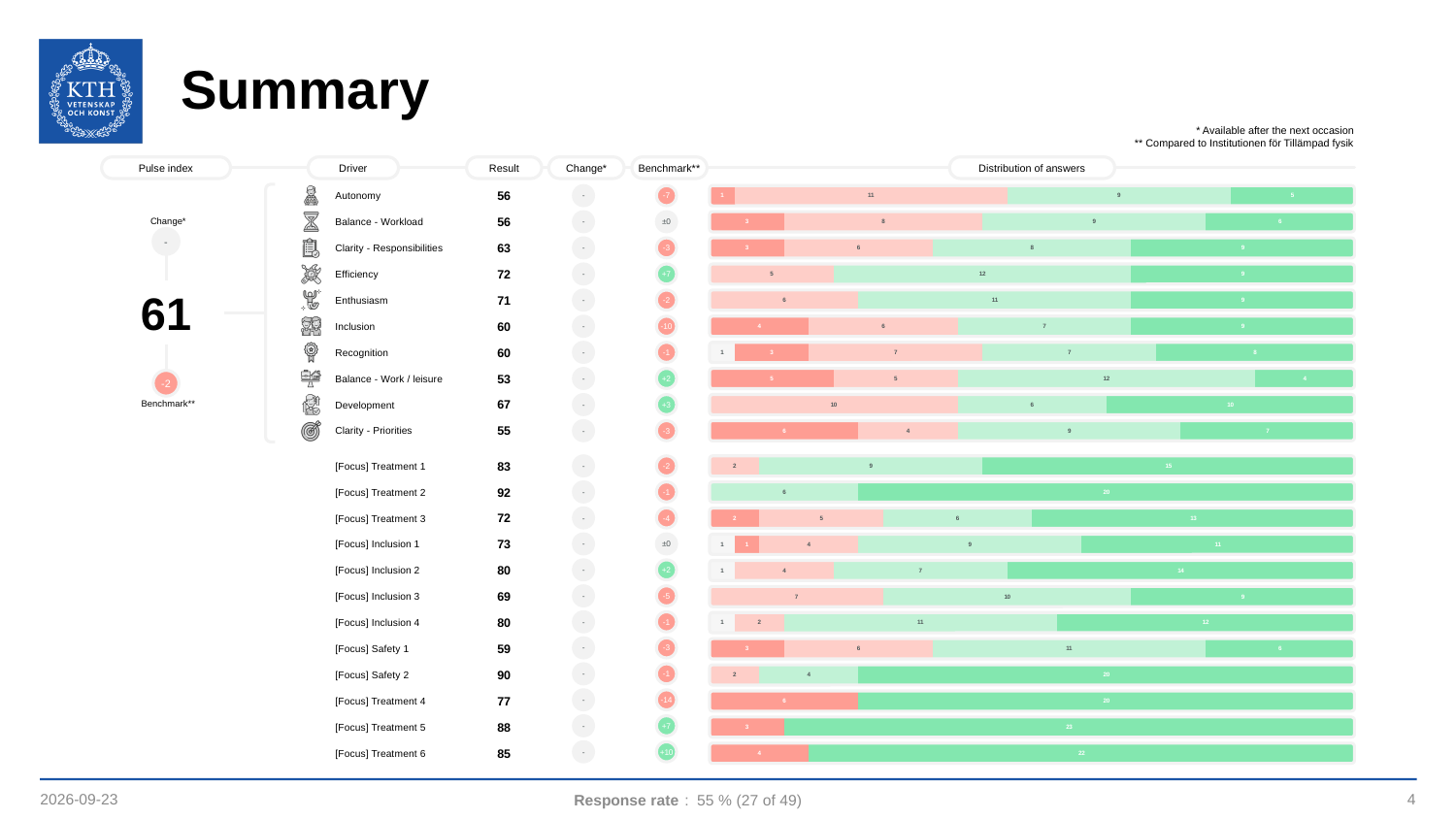
What is the Benchmark** value shown for Inclusion? -10 What is the Pulse index value shown on the slide? 61 Which driver has the highest Result value? [Focus] Treatment 2 What response rate is shown at the bottom of the slide? 55 % (27 of 49) What is the difference between the Result for [Focus] Safety 2 and the Result for [Focus] Safety 1? 31 What is the Result value for Autonomy? 56 Which has a higher Result, Efficiency or Enthusiasm? Efficiency What is the total number of answers in the Distribution of answers bar for [Focus] Treatment 2? 26 How many driver rows are listed in the table? 22 What kind of chart is used in the Distribution of answers column? Stacked bar chart What is the Result value for [Focus] Treatment 2? 92 Which driver has the lowest Result value? Balance - Work / leisure